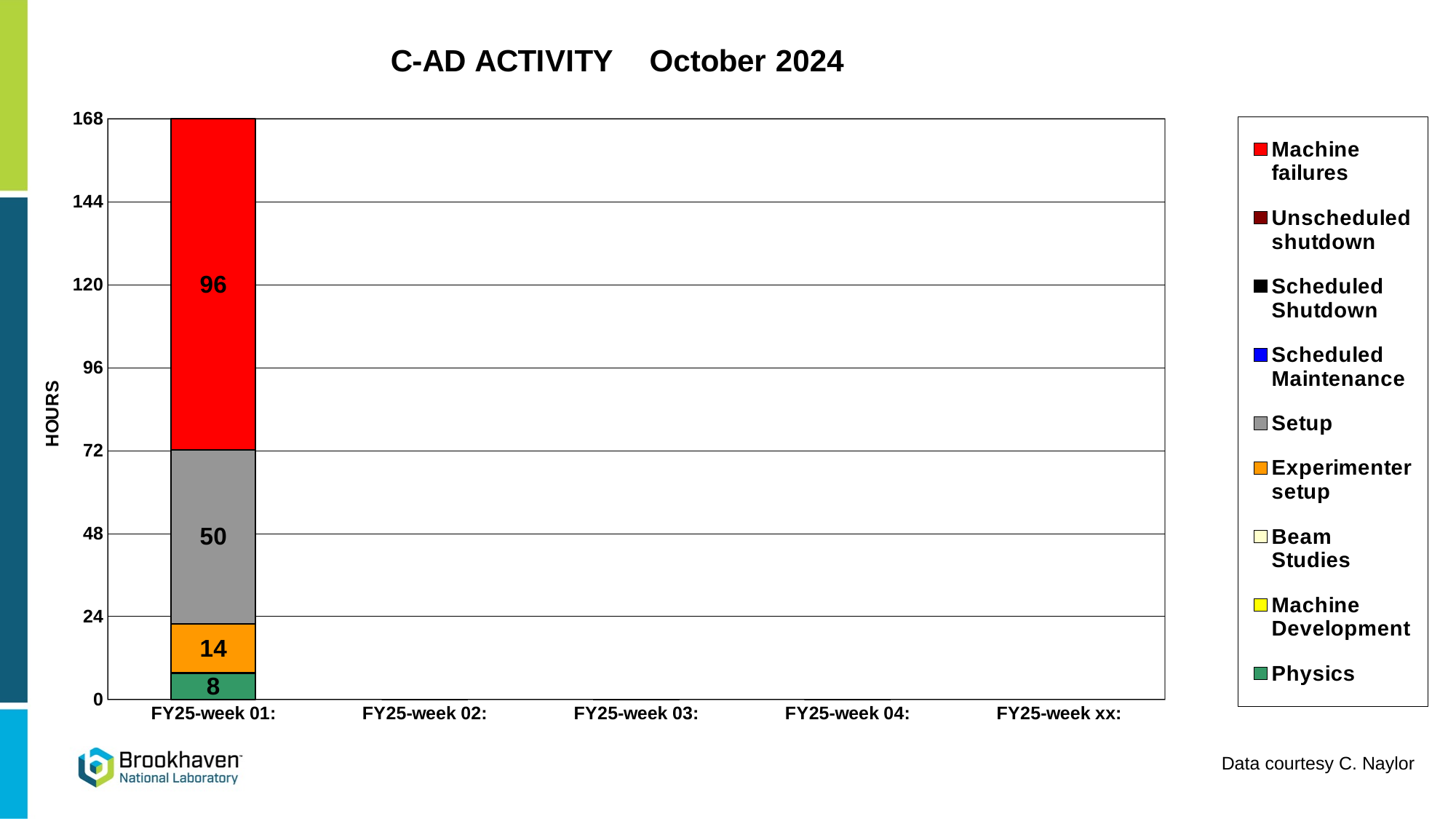
Which activity has the most hours in FY25-week 01? Machine failures How many hours of Experimenter setup are shown for FY25-week 01? 14 What kind of chart is shown on the slide? stacked bar chart How many hours of Physics are shown for FY25-week 01? 8 What is the total height of the FY25-week 01 stacked bar in hours? 168 How many hours of Machine failures are shown for FY25-week 01? 96 What is the difference in hours between Machine failures and Setup for FY25-week 01? 46 How many series does the legend list? 9 Which has more hours in FY25-week 01, Experimenter setup or Physics? Experimenter setup How many hours of Setup are shown for FY25-week 01? 50 What is the title of the chart? C-AD ACTIVITY October 2024